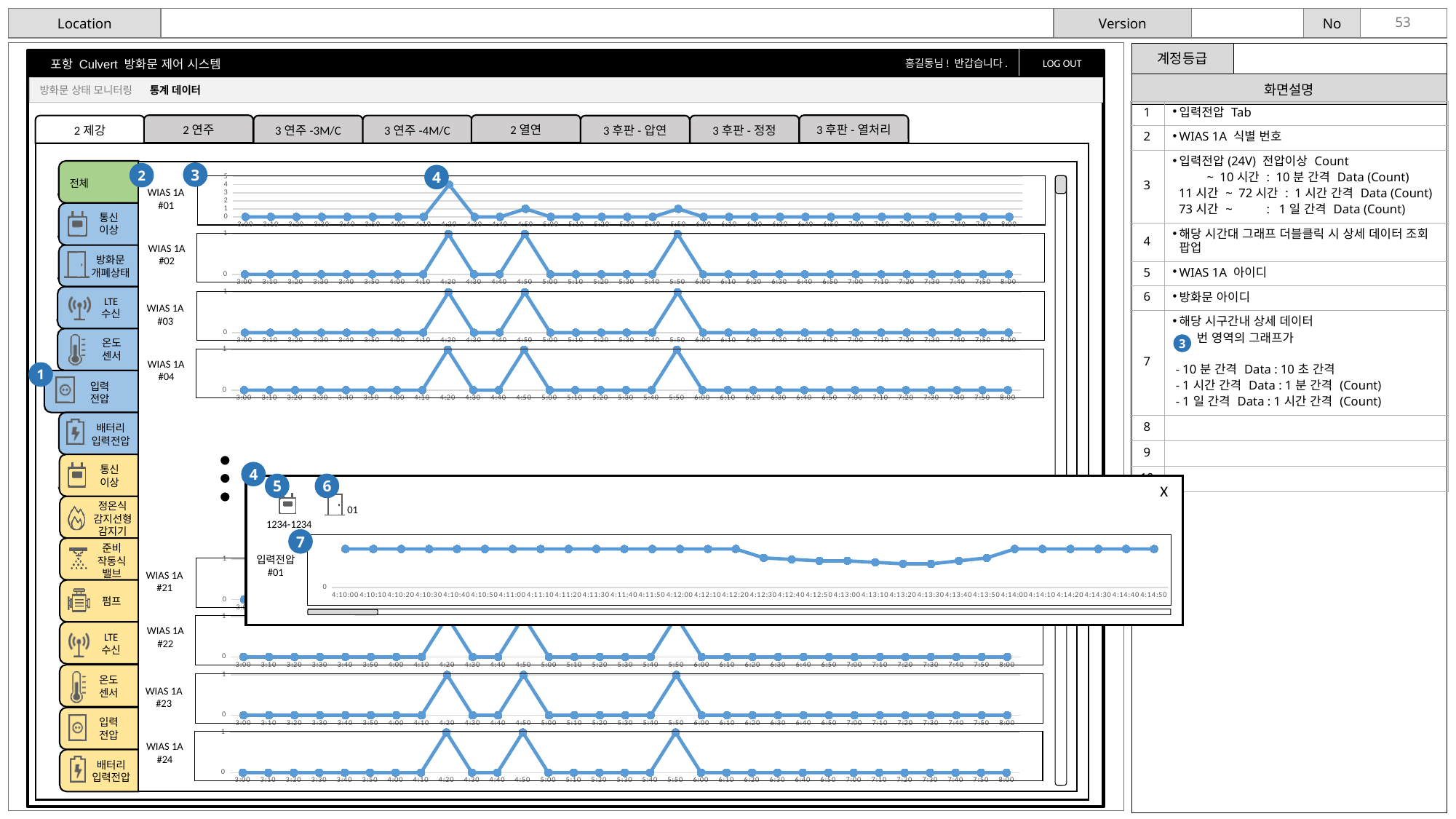
What is the last time label on the x axis of the WIAS 1A #24 chart? 8:00 In the WIAS 1A #04 chart, is the value at 6:00 greater or less than 1? less What is the first time label on the x axis of the WIAS 1A #02 chart? 3:00 In the WIAS 1A #01 chart, at which time is the value highest? 4:20 In the WIAS 1A #03 chart, what is the value at 3:00? 0 In the WIAS 1A #02 chart, what is the value at 4:20? 1 What is the highest tick on the y axis of the WIAS 1A #01 chart? 5 In the WIAS 1A #01 chart, is the value at 4:20 greater or less than 3? greater In the WIAS 1A #23 chart, what is the value at 5:50? 1 In the WIAS 1A #22 chart, does the value rise or fall from 4:20 to 4:30? fall In the WIAS 1A #01 chart, which is larger, the value at 4:20 or the value at 4:50? 4:20 What kind of chart is used for WIAS 1A #02? line chart